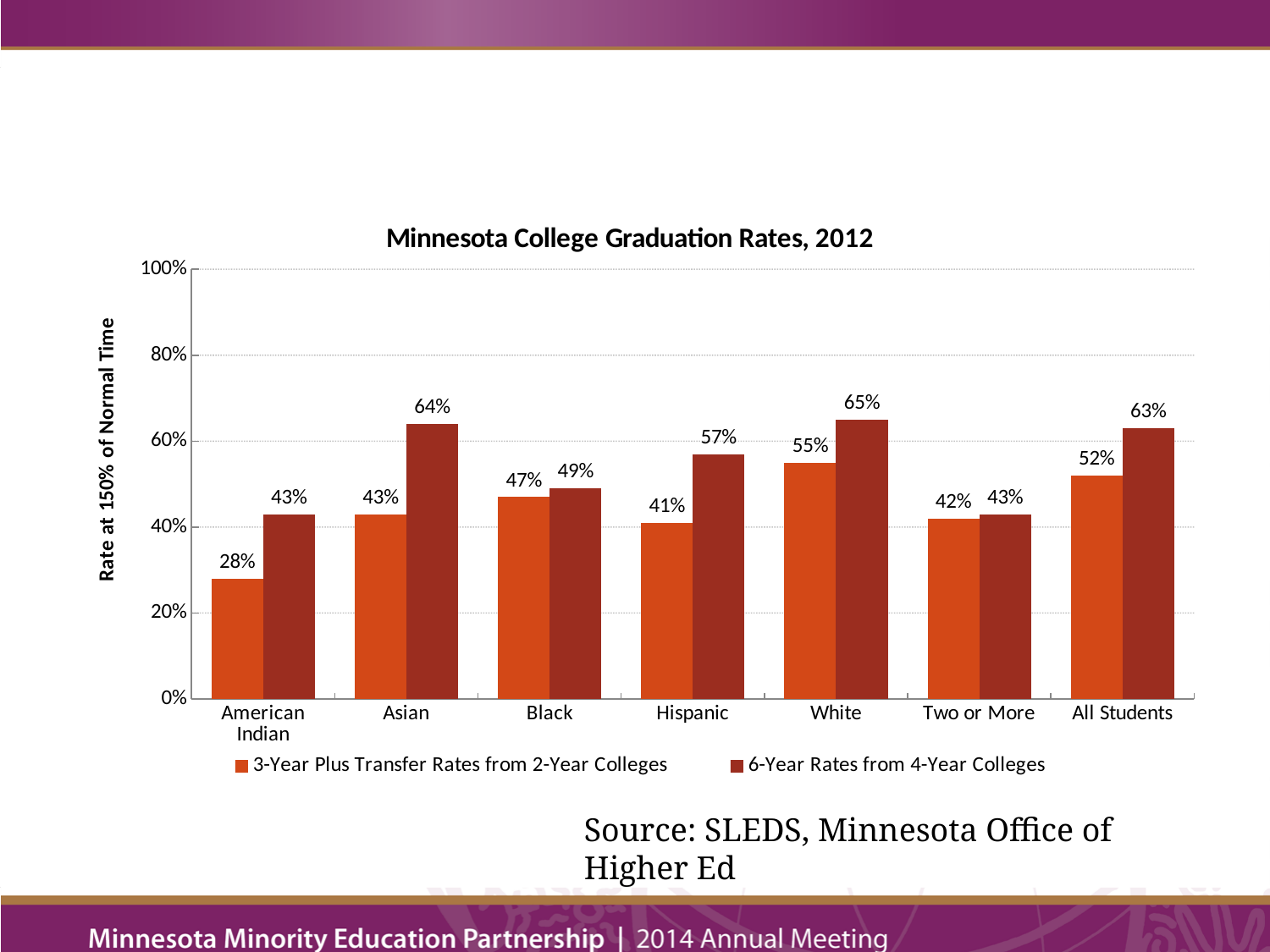
What is the label on the y axis? Rate at 150% of Normal Time Which category has the highest 6-Year Rate from 4-Year Colleges? White How many categories are shown on the x axis? 7 What kind of chart is shown on the slide? Bar chart What is the difference between the 6-Year Rate and the 3-Year Plus Transfer Rate for Hispanic students? 16% Which is larger for Black students: the 3-Year Plus Transfer Rate from 2-Year Colleges or the 6-Year Rate from 4-Year Colleges? 6-Year Rates from 4-Year Colleges Is the 6-Year Rate from 4-Year Colleges for All Students greater or less than 60%? greater What is the 6-Year Rate from 4-Year Colleges for Asian students? 64% Which category has the lowest 3-Year Plus Transfer Rate from 2-Year Colleges? American Indian What is the title of the chart? Minnesota College Graduation Rates, 2012 How many series does the legend list? 2 What is the 3-Year Plus Transfer Rate from 2-Year Colleges for American Indian students? 28%